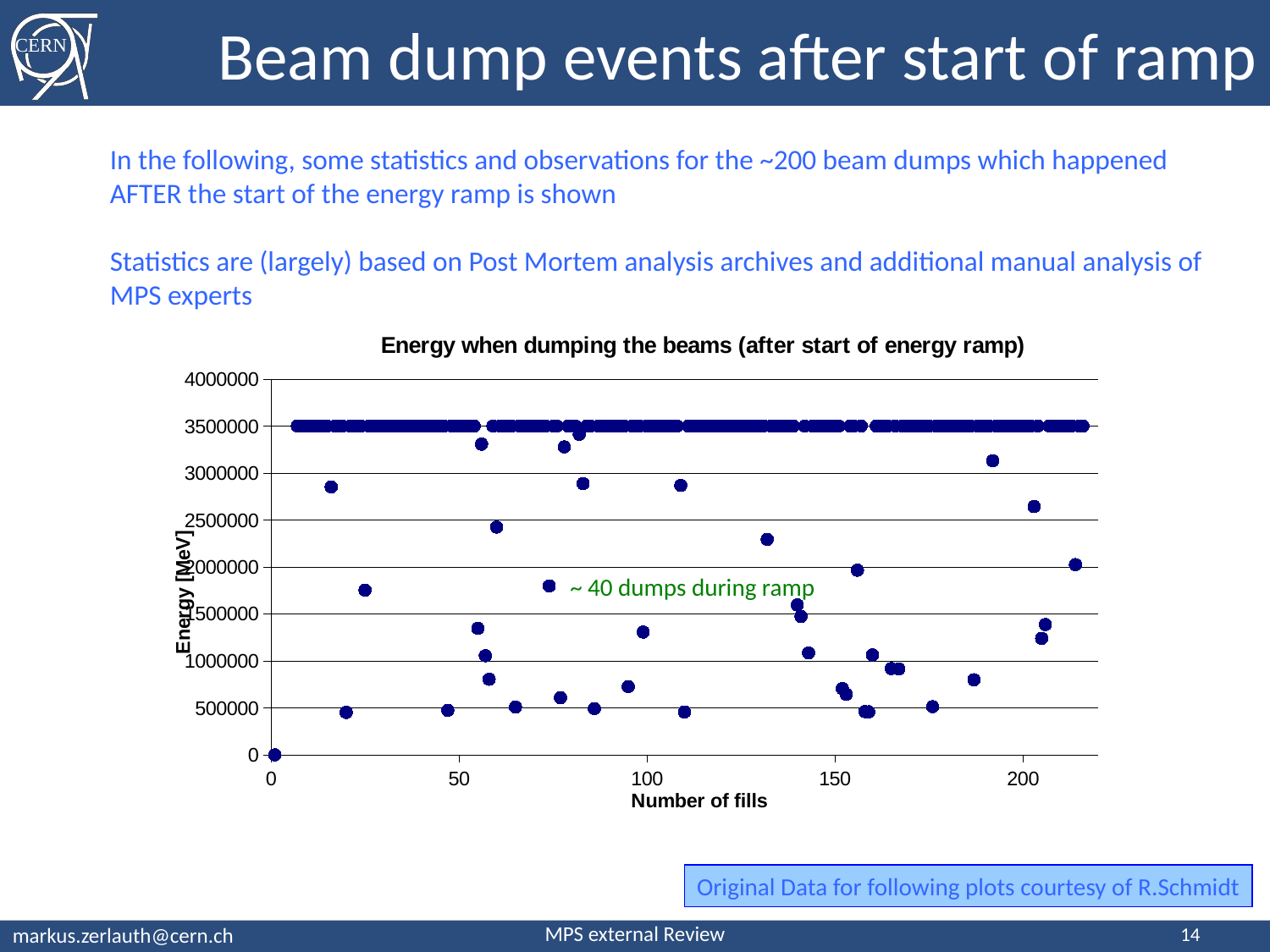
What is the maximum value shown on the y axis? 4000000 What is the label of the y axis of the chart? Energy [MeV] Is the energy value for the point at fill number 0 greater or less than 500000? less At what energy value do most of the plotted points cluster? 3500000 What is the title of the chart? Energy when dumping the beams (after start of energy ramp) Is the energy value for the isolated point near fill number 130 greater or less than 2500000? less What kind of chart is shown on the slide? Scatter chart Is the energy value for the isolated point near fill number 25 greater or less than 1500000? greater